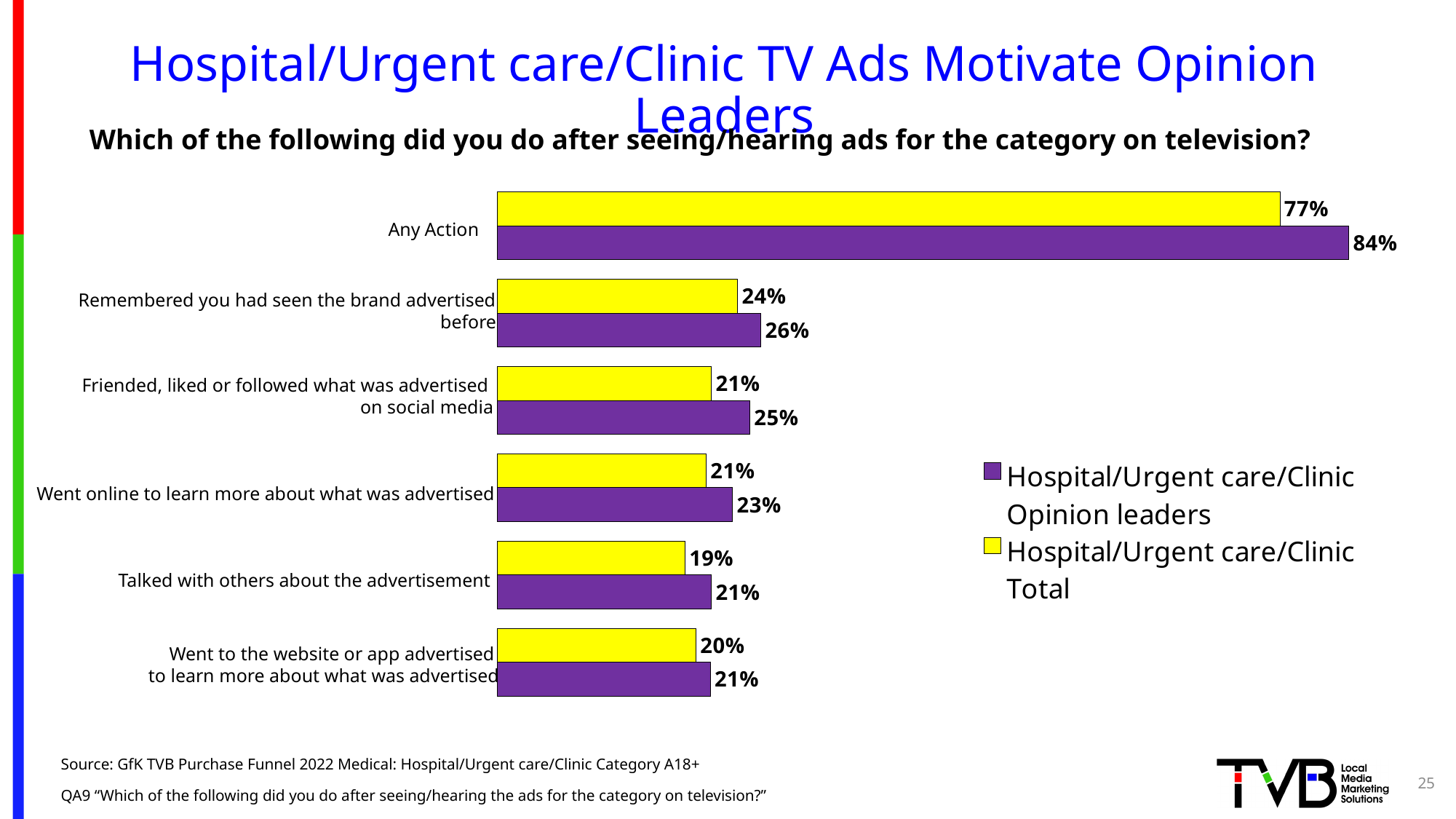
What is the value for Any Action for Hospital/Urgent care/Clinic Opinion leaders? 84% How many categories are shown on the chart? 6 What is the value for 'Talked with others about the advertisement' for Hospital/Urgent care/Clinic Total? 19% What is the difference between the Opinion leaders and Total values for Any Action? 7% Which category has the highest value for Hospital/Urgent care/Clinic Opinion leaders? Any Action What is the value for 'Friended, liked or followed what was advertised on social media' for Hospital/Urgent care/Clinic Opinion leaders? 25% What kind of chart is shown on the slide? Bar chart What is the difference between the Opinion leaders and Total values for 'Friended, liked or followed what was advertised on social media'? 4% Which category has the lowest value for Hospital/Urgent care/Clinic Total? Talked with others about the advertisement For 'Remembered you had seen the brand advertised before', which series has the larger value: Opinion leaders or Total? Opinion leaders What is the value for Any Action for Hospital/Urgent care/Clinic Total? 77% How many series does the legend list? 2